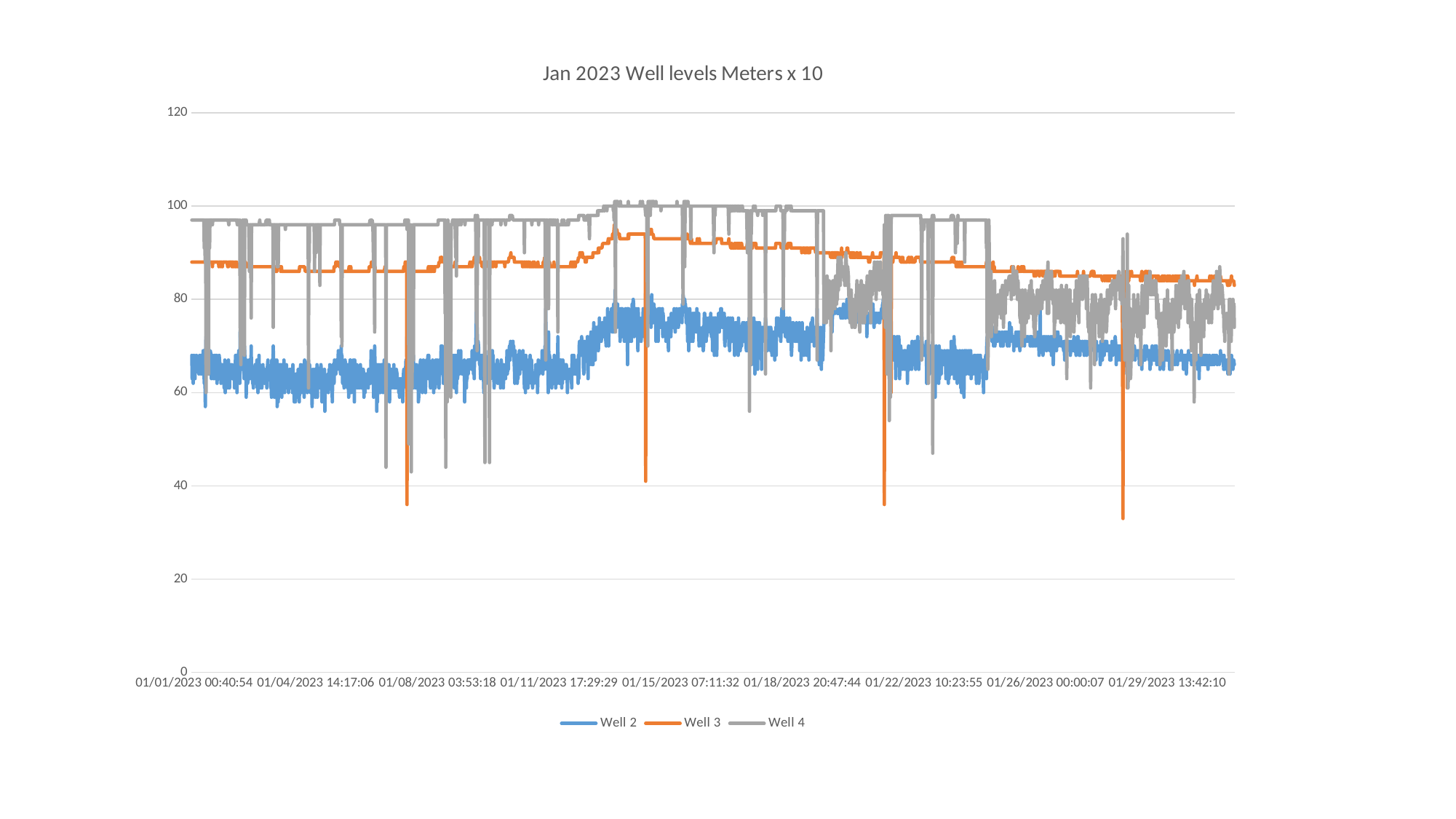
Which series has the lowest values for most of the chart? Well 2 At the start of the chart (01/01/2023), which series has the higher value, Well 2 or Well 4? Well 4 What is the title of the chart? Jan 2023 Well levels Meters x 10 Is the value for Well 2 at the end of the chart (around 01/29/2023) greater or less than 80? less Is the value for Well 2 at the start of the chart (01/01/2023) greater or less than 80? less At the start of the chart (01/01/2023), which series has the lower value, Well 2 or Well 3? Well 2 What kind of chart is shown on the slide? line chart Is the value for Well 4 at the start of the chart (01/01/2023) greater or less than 80? greater Which series are listed in the legend? Well 2, Well 3, Well 4 How many series does the legend list? 3